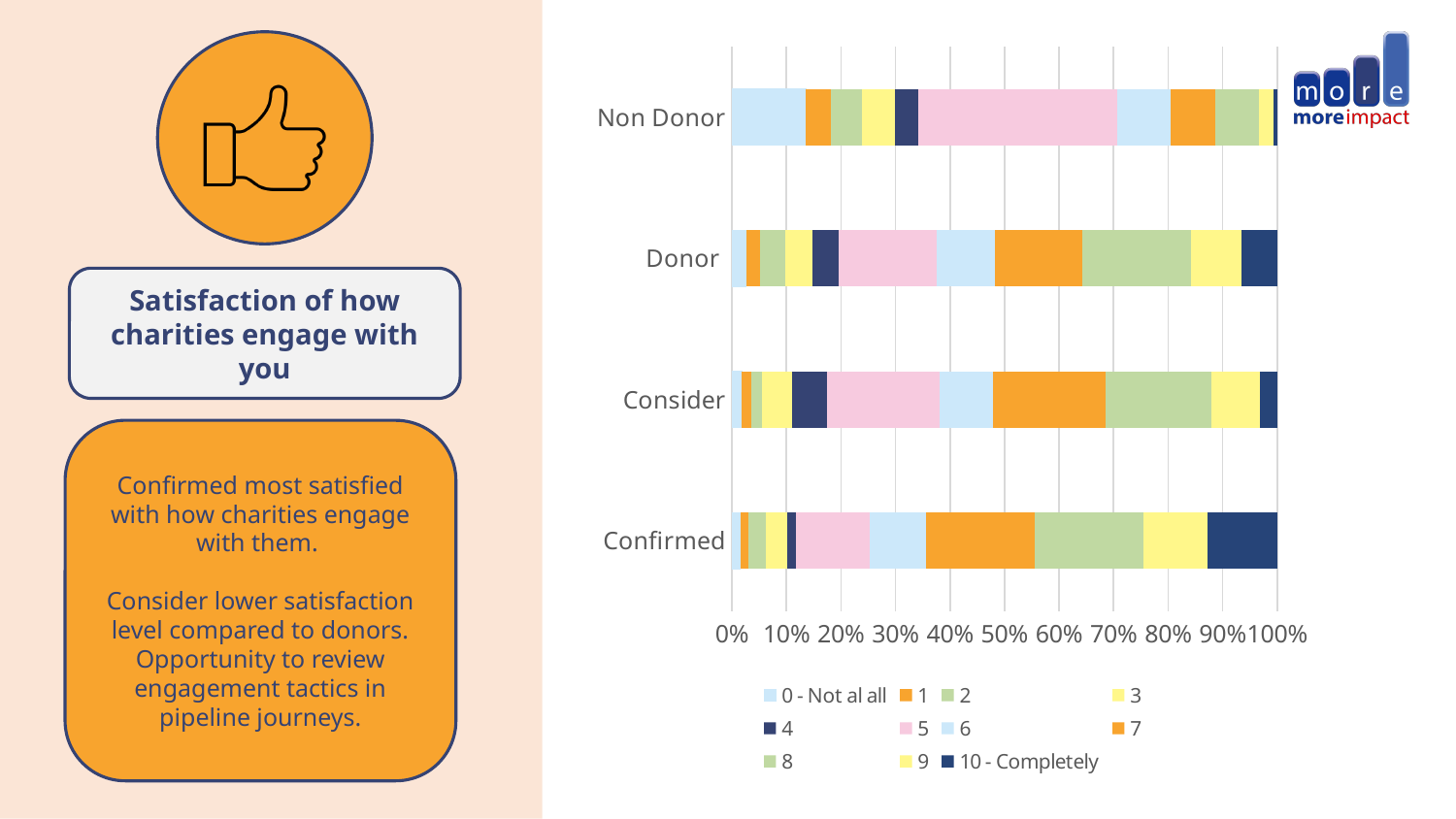
Is the '5' segment for Non Donor greater or less than 30%? less How many categories are plotted on the vertical axis of the chart? 4 What kind of chart is shown on the slide? Stacked bar chart What is the label of the last entry in the chart legend? 10 - Completely Is the '10 - Completely' segment for Consider greater or less than 10%? less Which category has the largest '0 - Not al all' segment? Non Donor Which category has the largest '10 - Completely' segment? Confirmed What is the label of the first entry in the chart legend? 0 - Not al all Which is larger: the '10 - Completely' segment for Confirmed or for Donor? Confirmed How many series does the chart legend list? 11 Which category has the largest '5' segment? Non Donor